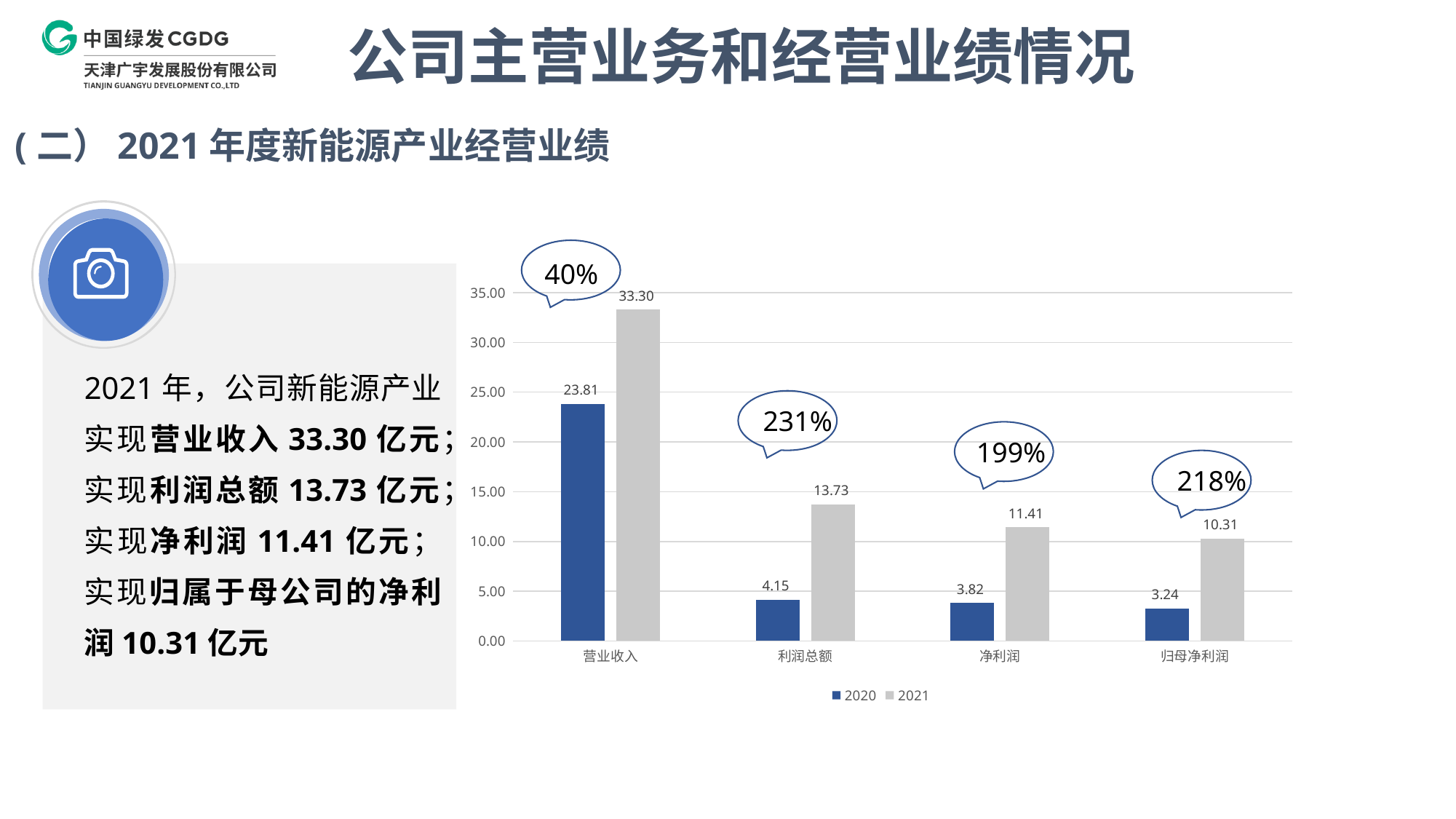
What is the 2020 value for 利润总额? 4.15 How many categories are shown on the x axis? 4 What kind of chart is shown on the slide? bar chart Is the 2020 value for 营业收入 greater or less than 20.00? greater Which is larger, the 2021 value for 利润总额 or the 2021 value for 净利润? 2021 value for 利润总额 What is the difference between the 2021 and 2020 values for 营业收入? 9.49 How many series does the legend list? 2 What is the 2020 value for 归母净利润? 3.24 What is the 2021 value for 营业收入? 33.30 Which category has the lowest 2020 value? 归母净利润 Which category has the highest 2021 value? 营业收入 What is the 2021 value for 净利润? 11.41